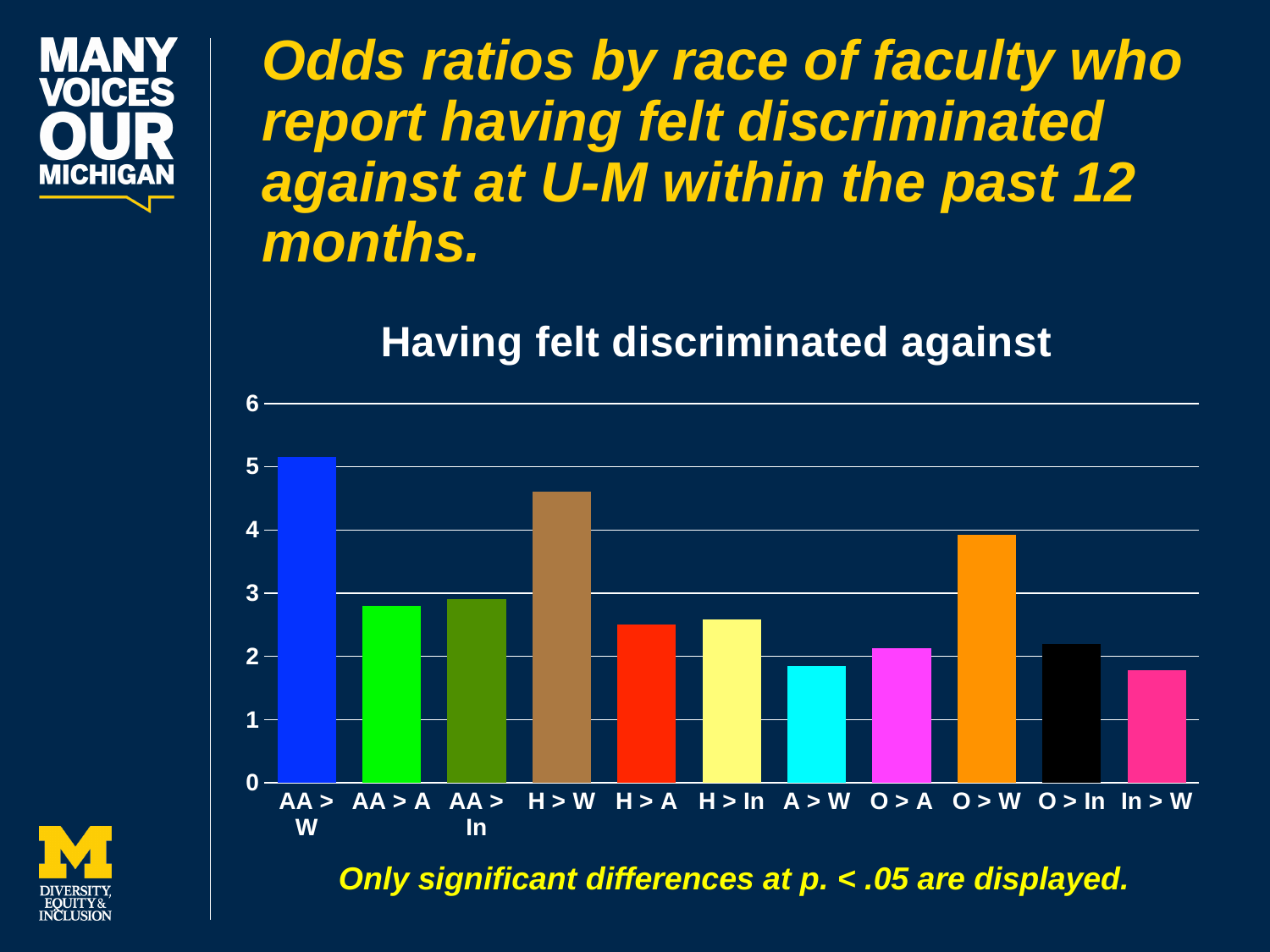
Is the value for AA > A greater or less than 3? less Is the value for H > W greater or less than 4? greater How many categories are plotted along the x axis of the chart? 11 Which category has the highest bar in the chart? AA > W Which is larger, the value for H > W or the value for O > W? H > W Is the value for O > W greater or less than 3? greater What is the title of the chart? Having felt discriminated against Which is larger, the value for AA > W or the value for H > W? AA > W What kind of chart is shown on the slide? bar chart